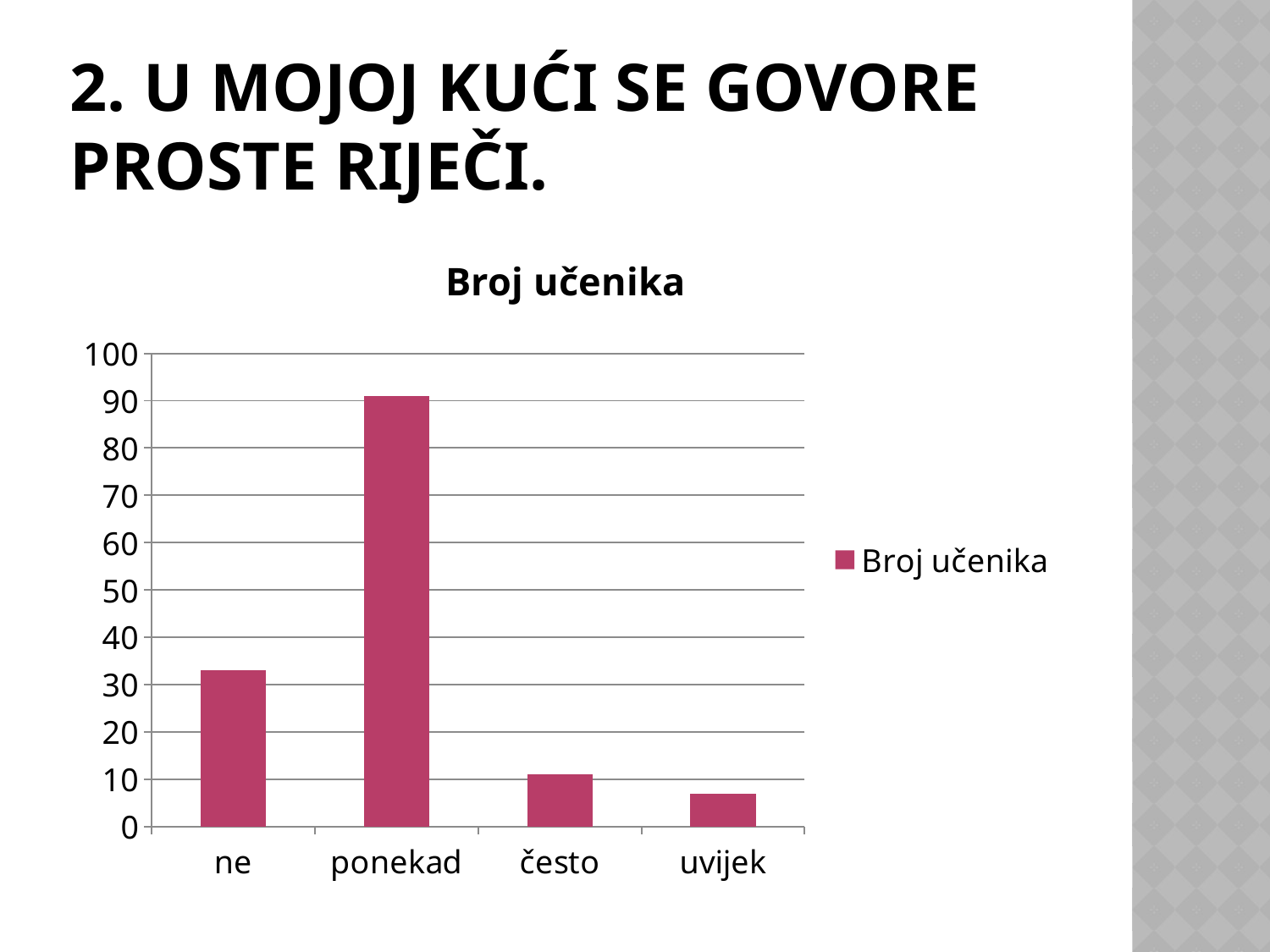
What type of chart is shown on the slide? bar chart What is the name of the series shown in the legend? Broj učenika What is the title of the chart? Broj učenika Is the value for ponekad greater or less than 80? greater Is the value for često greater or less than 20? less Which is larger, the value for ne or the value for često? ne How many categories are shown on the x axis of the chart? 4 Which category has the highest value? ponekad Is the value for uvijek greater or less than 10? less How many series does the legend list? 1 Which category has the lowest value? uvijek